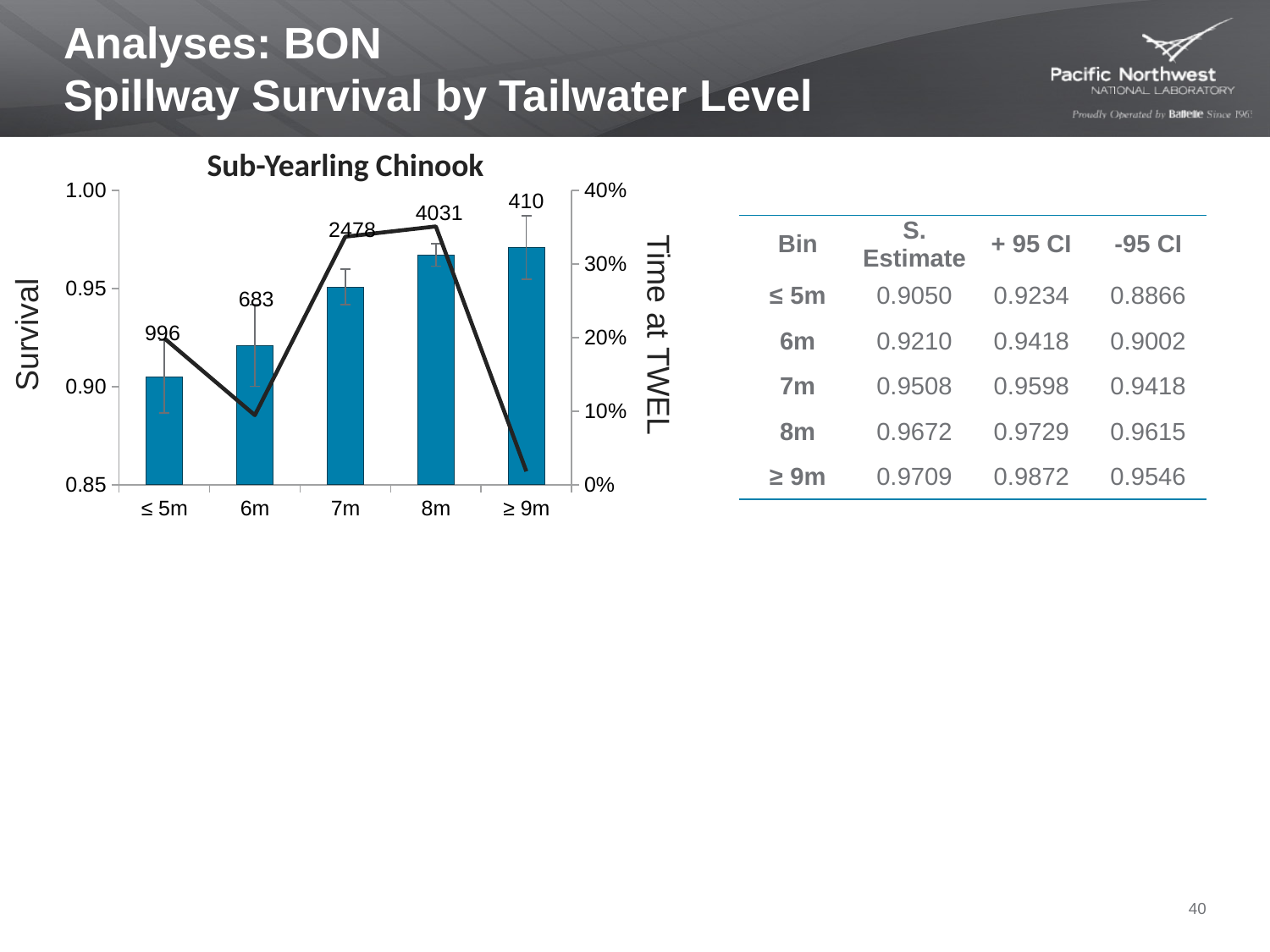
Which bin has the lowest survival bar? ≤ 5m What is the difference between the numbers printed above the 8m and 7m bars? 1553 What is the label on the right-hand vertical axis of the chart? Time at TWEL Which bar has the larger printed number, 6m or ≥ 9m? 6m What number is printed above the 8m bar? 4031 What is the title of the chart? Sub-Yearling Chinook What kind of chart is shown on the slide? Bar chart with a line overlay How many tailwater level bins are shown on the x axis of the chart? 5 What number is printed above the ≤ 5m bar? 996 Which bin has the lowest Time at TWEL value on the line? ≥ 9m Do the survival bars generally rise or fall from ≤ 5m to ≥ 9m? rise Is the Time at TWEL value for 8m greater or less than 30%? greater